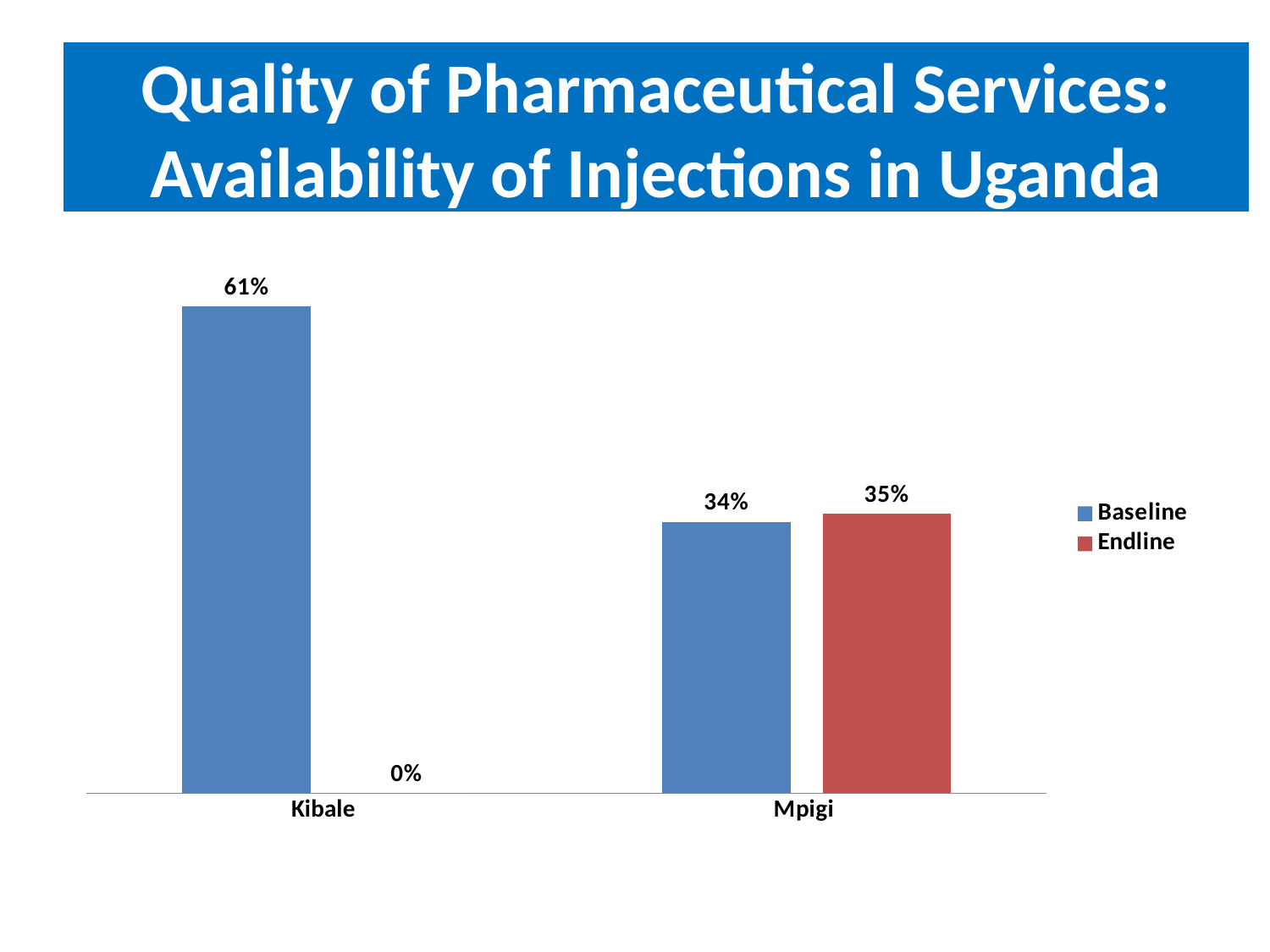
What kind of chart is shown on the slide? Bar chart Which category has the lowest Endline value? Kibale What is the difference between the Baseline values for Kibale and Mpigi? 27% What is the difference between the Endline and Baseline values for Mpigi? 1% How many series does the legend list? 2 What is the Endline value for Kibale? 0% Which is larger: the Baseline value for Kibale or the Baseline value for Mpigi? Kibale What is the Endline value for Mpigi? 35% How many categories are shown on the x axis? 2 Which category has the highest Baseline value? Kibale What is the Baseline value for Mpigi? 34% What is the Baseline value for Kibale? 61%